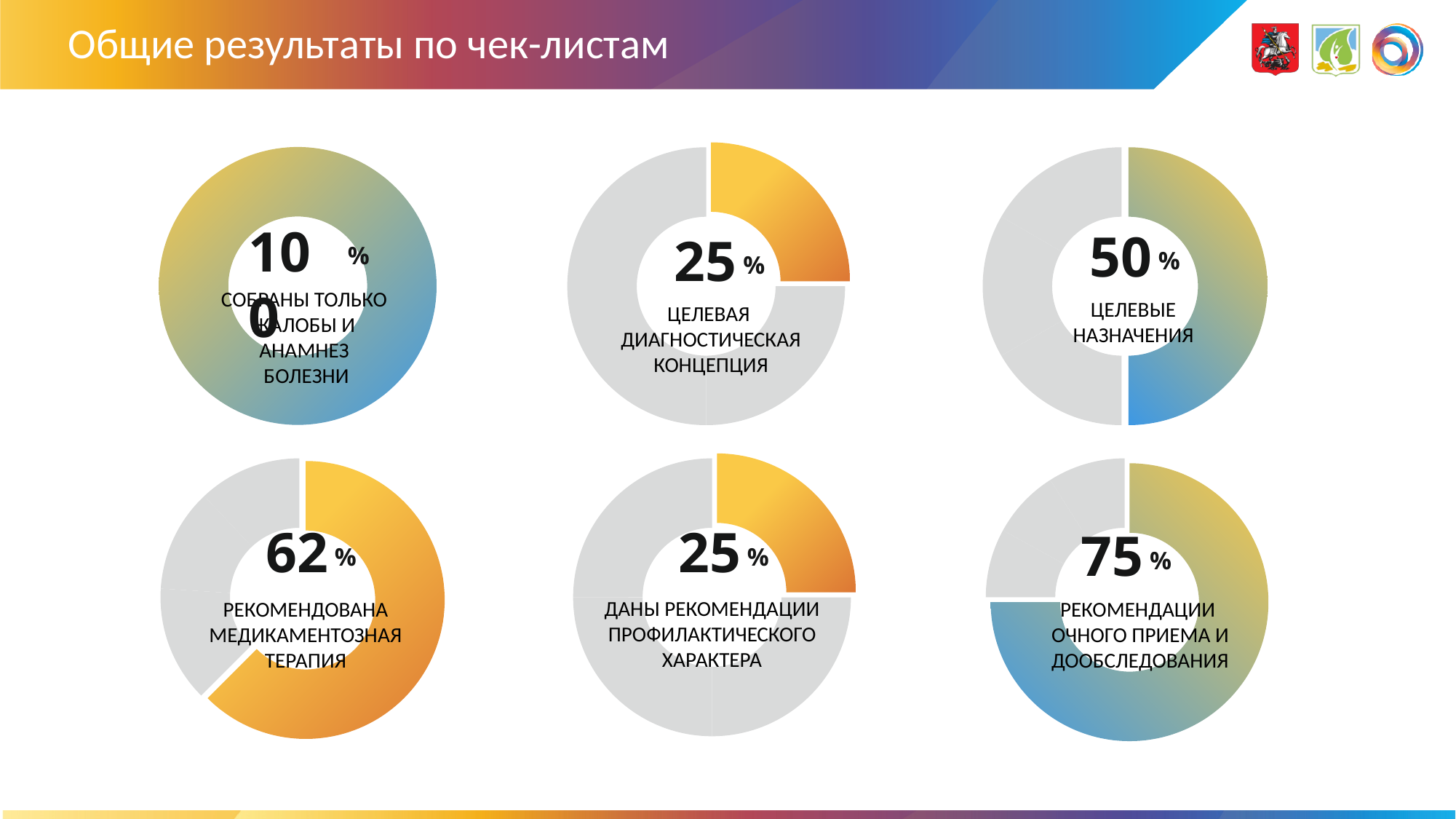
What value is shown in the donut chart labelled «Целевая диагностическая концепция»? 25% What value is shown in the donut chart labelled «Целевые назначения»? 50% What is the title of the slide? Общие результаты по чек-листам What value is shown in the donut chart labelled «Рекомендации очного приема и дообследования»? 75% Which is larger: the value for «Рекомендована медикаментозная терапия» or the value for «Целевые назначения»? Рекомендована медикаментозная терапия What is the difference between the value for «Рекомендации очного приема и дообследования» and the value for «Целевые назначения»? 25% What value is shown in the donut chart labelled «Даны рекомендации профилактического характера»? 25% Which chart in the bottom row shows the lowest value? Даны рекомендации профилактического характера How many donut charts are shown on the slide? 6 What kind of chart is used for each of the six indicators on the slide? Donut (pie) chart What is the difference between the value for «Рекомендации очного приема и дообследования» and the value for «Рекомендована медикаментозная терапия»? 13% What value is shown in the donut chart labelled «Рекомендована медикаментозная терапия»? 62%